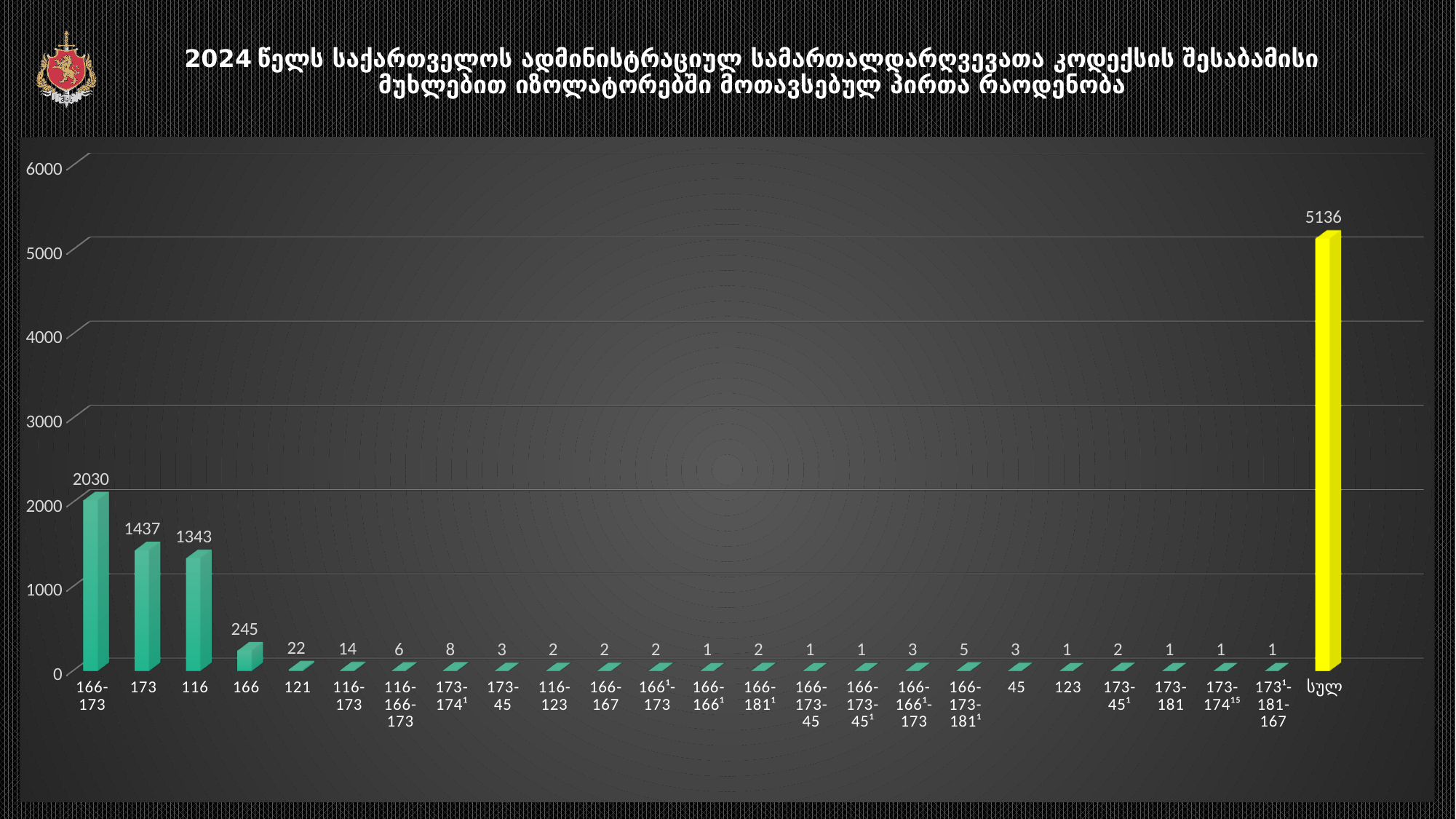
What is the value for the category 116? 1343 What is the value shown for the yellow bar labelled სულ? 5136 What is the difference between the values for 173 and 116? 94 What is the difference between the values for 166-173 and 173? 593 How many bars are plotted on the chart, including the სულ bar? 25 What is the value for the category 173? 1437 Which is larger, the value for 121 or the value for 116-173? 121 Is the value for 166-173 greater or less than 2000? greater What is the value for the category 166? 245 What kind of chart is shown on the slide? bar chart What is the value for the category 166-173? 2030 Excluding the სულ total bar, which category has the highest value? 166-173